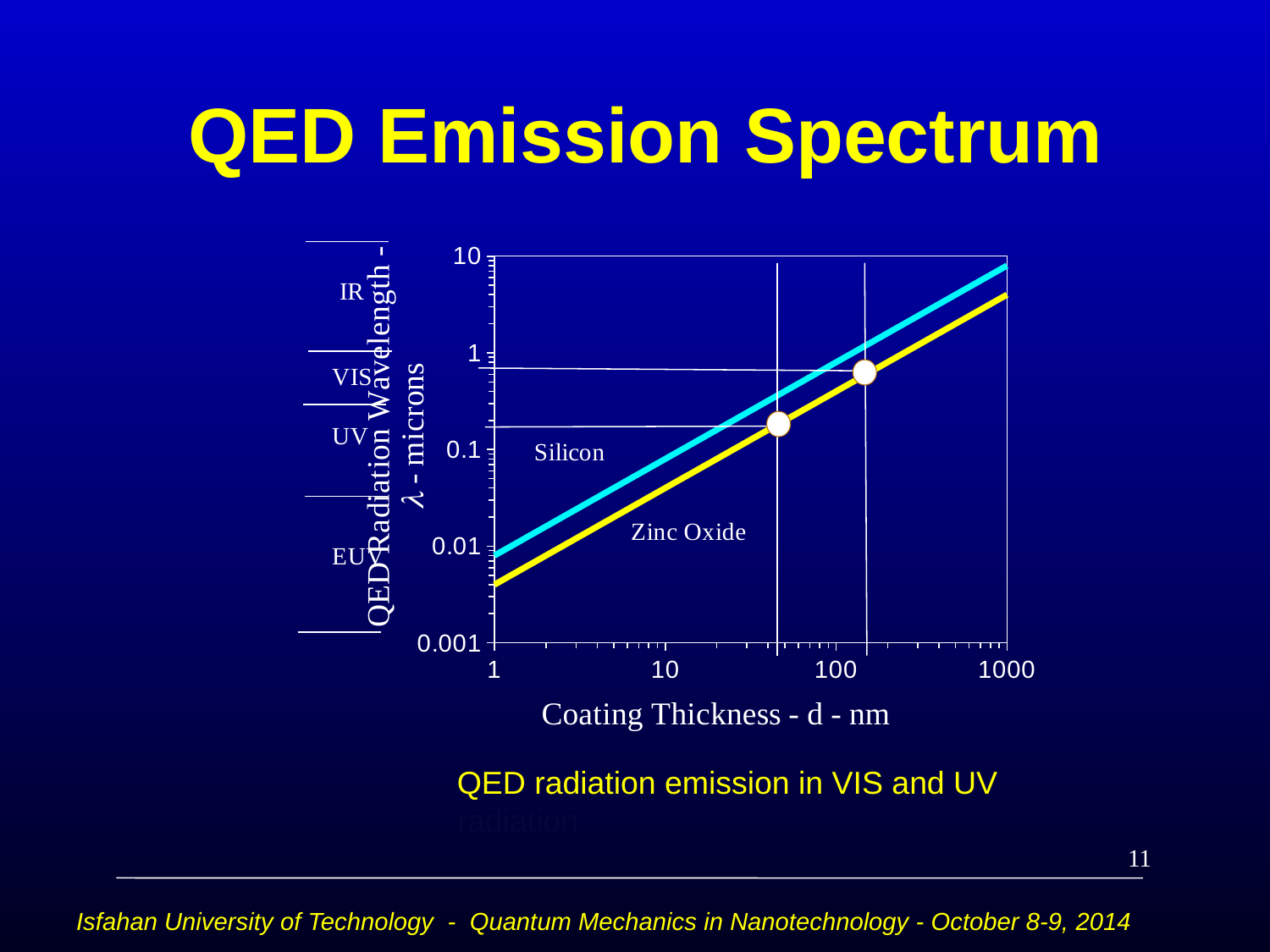
What is the label of the x axis? Coating Thickness - d - nm Is the wavelength for Zinc Oxide at a coating thickness of 10 nm greater or less than 0.1 microns? less How many series (lines) are plotted on the chart? 2 What is the highest value shown on the y axis of the chart? 10 Which series has the higher wavelength at a coating thickness of 100 nm, Silicon or Zinc Oxide? Silicon Which series has the lower wavelength at a coating thickness of 10 nm, Silicon or Zinc Oxide? Zinc Oxide Is the wavelength for Silicon at a coating thickness of 1000 nm greater or less than 1 micron? greater What kind of chart is shown on the slide? Line chart What are the names of the two series plotted on the chart? Silicon and Zinc Oxide Does the QED radiation wavelength rise or fall as coating thickness increases? Rise Is the wavelength for Silicon at a coating thickness of 100 nm greater or less than 0.1 microns? greater